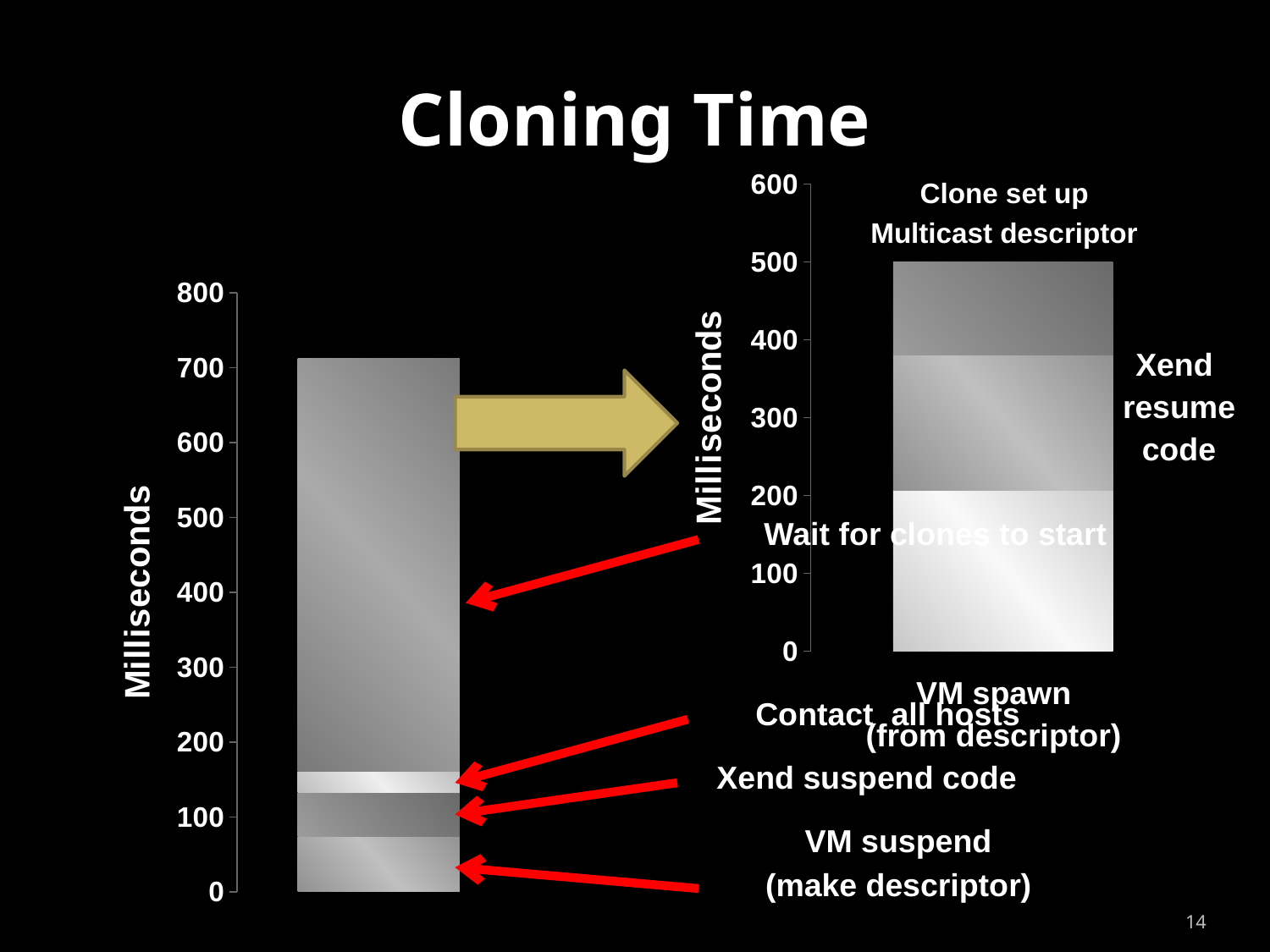
In the left chart, is the total height of the stacked bar greater or less than 800 milliseconds? less In the right chart, which segment of the stacked bar is the largest? VM spawn (from descriptor) In the left chart, which segment of the stacked bar is the largest? Wait for clones to start In the right chart, is the total height of the stacked bar greater or less than 600 milliseconds? less In the left chart, which is larger: the 'Wait for clones to start' segment or the 'Xend suspend code' segment? Wait for clones to start What is the y-axis label on the left chart? Milliseconds In the right chart, is the total height of the stacked bar greater or less than 400 milliseconds? greater What kind of chart is shown on the left of the slide? bar chart What is the title of the slide containing the charts? Cloning Time What kind of chart is shown on the right of the slide? bar chart How many segments make up the stacked bar in the right chart? 3